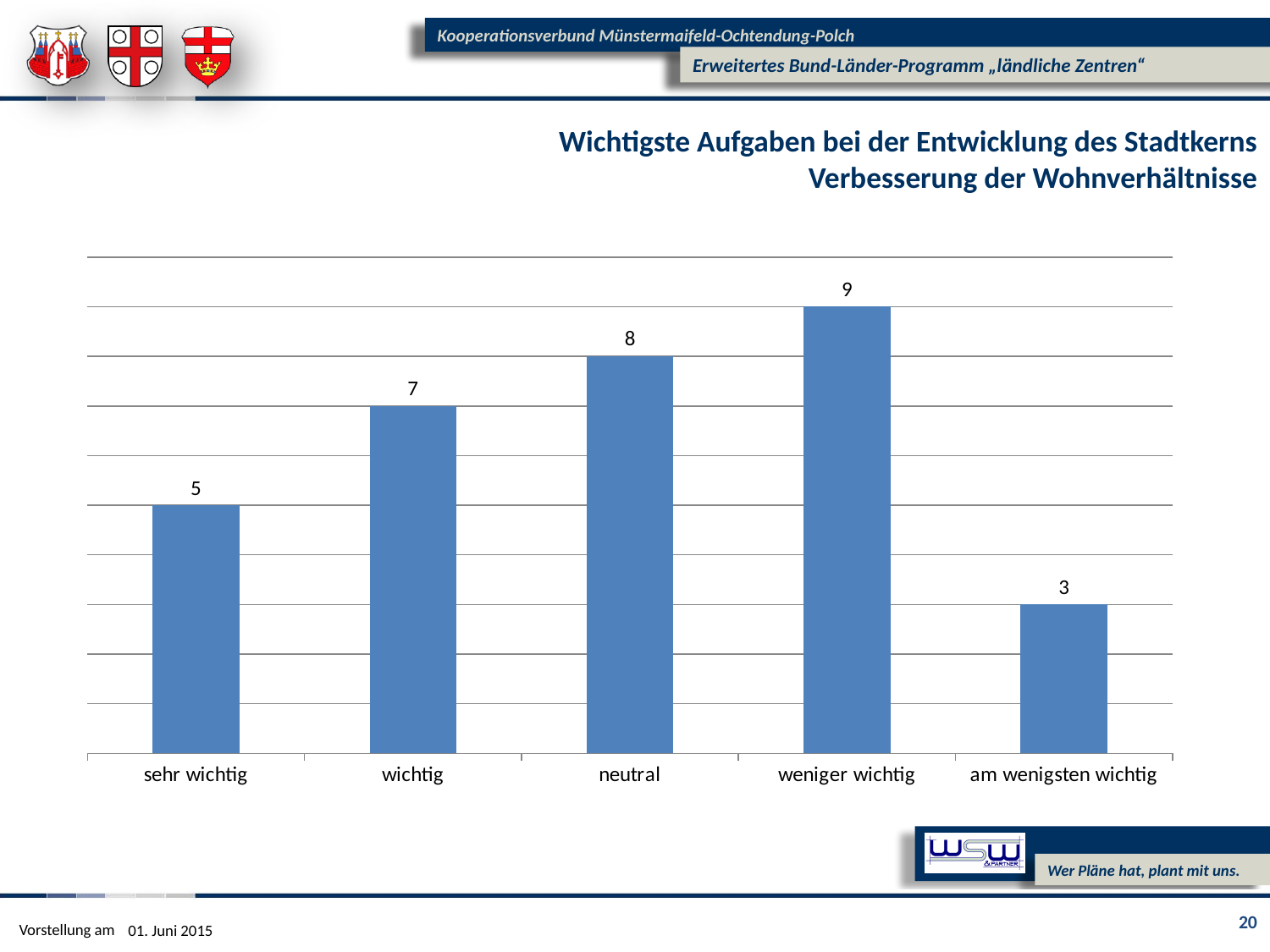
Which is larger, the value for "sehr wichtig" or the value for "neutral"? neutral What is the difference between the values for "weniger wichtig" and "am wenigsten wichtig"? 6 What is the value for "weniger wichtig"? 9 What is the value for "neutral"? 8 What kind of chart is shown on the slide? bar chart Which category has the lowest value? am wenigsten wichtig What is the second line of the chart's title? Verbesserung der Wohnverhältnisse What is the value for "am wenigsten wichtig"? 3 What is the value for "sehr wichtig"? 5 Which category has the highest value? weniger wichtig What is the value for "wichtig"? 7 How many categories are shown on the x axis? 5